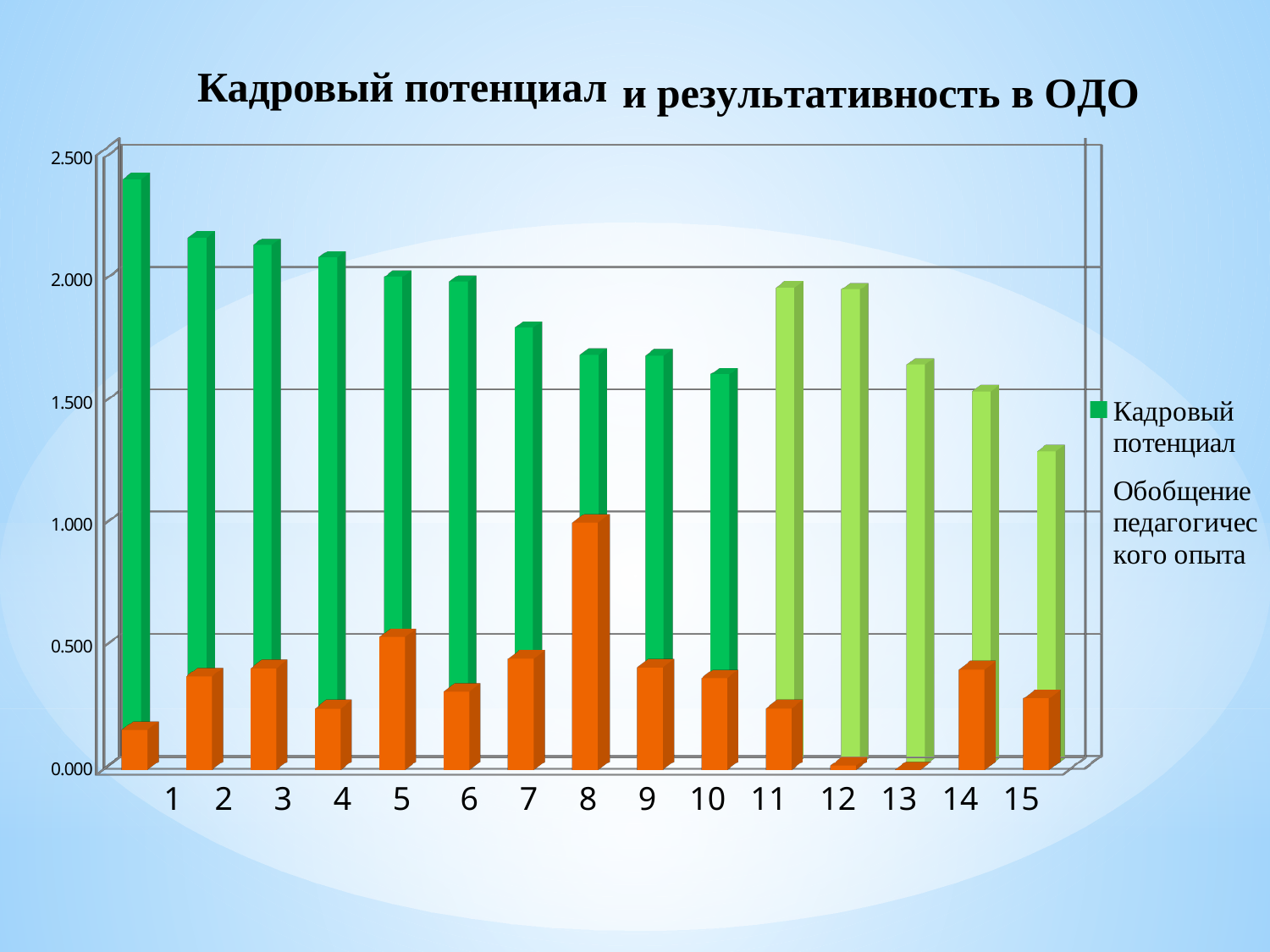
Is the value for Обобщение педагогического опыта in category 8 greater or less than 0.500? greater Which is larger: the Кадровый потенциал value for category 1 or for category 15? category 1 Which category has the highest value for Обобщение педагогического опыта? 8 Is the value for Кадровый потенциал in category 15 greater or less than 1.500? less Which category has the lowest value for Кадровый потенциал? 15 What is the title of the chart on the slide? Кадровый потенциал и результативность в ОДО How many categories are shown on the x axis of the chart? 15 Do the Кадровый потенциал values rise or fall from category 1 to category 10? fall Is the value for Кадровый потенциал in category 1 greater or less than 2.000? greater What kind of chart is shown on the slide? bar chart How many series does the chart's legend list? 2 Which category has the highest value for Кадровый потенциал? 1